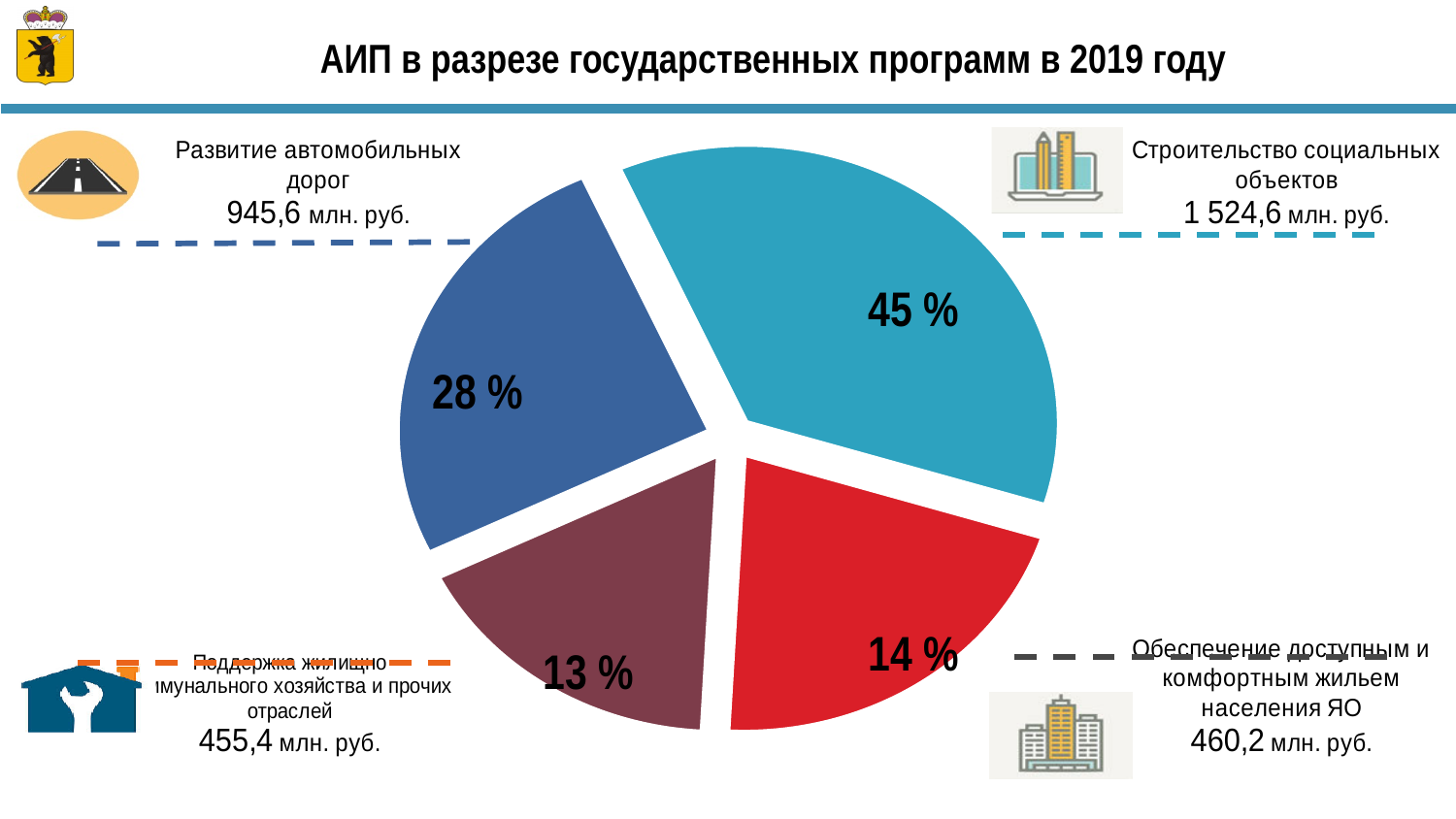
What share of the pie is labelled for Развитие автомобильных дорог? 28 % What is the title of the slide containing the pie chart? АИП в разрезе государственных программ в 2019 году Which program has the largest share of the pie? Строительство социальных объектов (45 %) What is the amount shown for Обеспечение доступным и комфортным жильем населения ЯО? 460,2 млн. руб. What kind of chart is shown on the slide? pie chart What is the amount shown for Строительство социальных объектов? 1 524,6 млн. руб. Which is larger: the amount for Обеспечение доступным и комфортным жильем населения ЯО or for Поддержка жилищно-коммунального хозяйства и прочих отраслей? Обеспечение доступным и комфортным жильем населения ЯО (460,2 млн. руб.) What is the amount shown for Развитие автомобильных дорог? 945,6 млн. руб. What share of the pie does the largest slice (Строительство социальных объектов) represent? 45 % By how many percentage points does the 45 % slice exceed the 28 % slice? 17 How many slices does the pie chart have? 4 Which program has the smallest share of the pie? Поддержка жилищно-коммунального хозяйства и прочих отраслей (13 %)